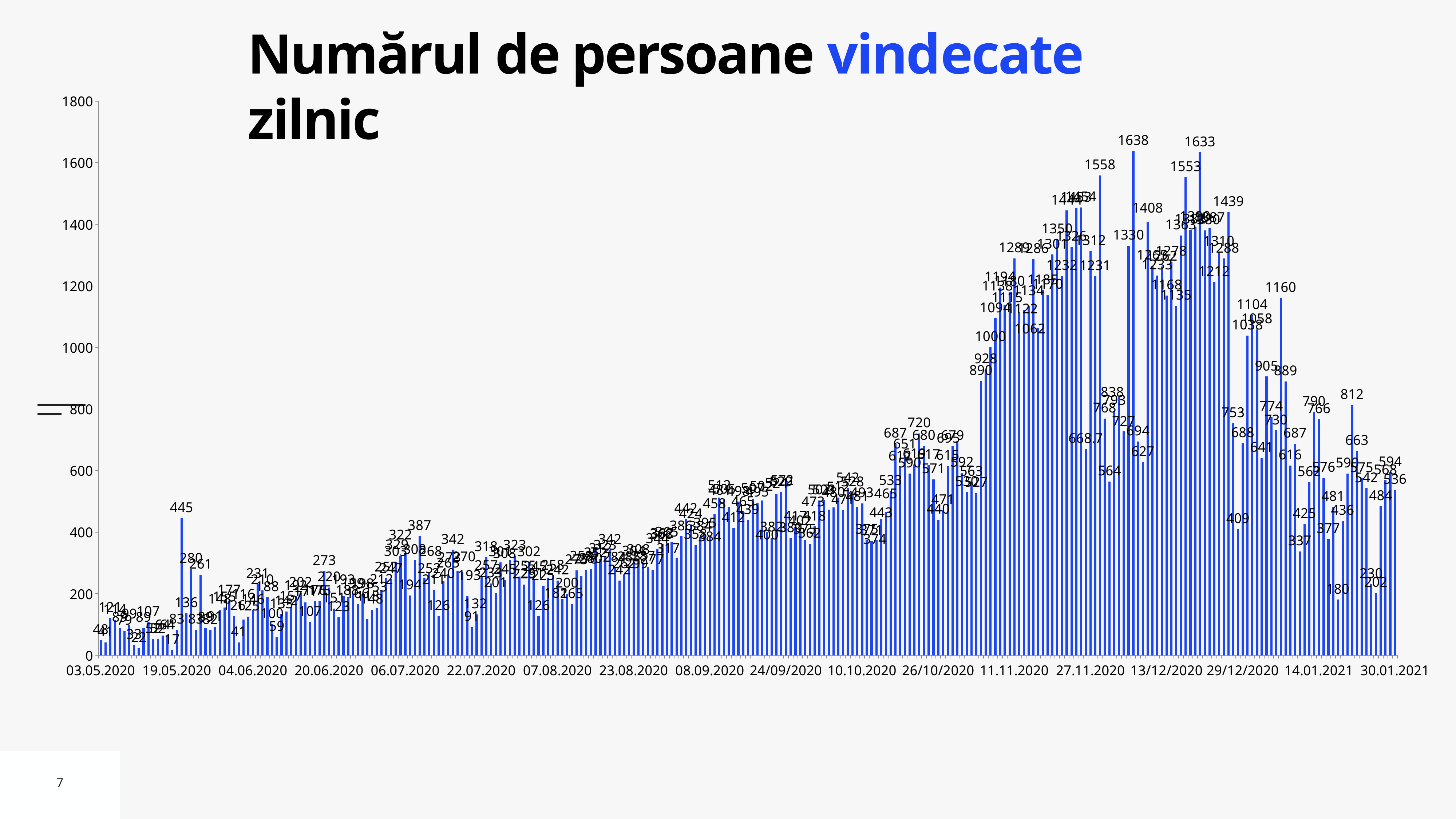
What is the first date shown on the horizontal axis? 03.05.2020 What is the highest daily value labelled on the chart? 1638 What is the value of the last bar on the chart (30.01.2021)? 536 What is the highest value shown on the vertical axis? 1800 Overall, do the daily values rise or fall from May 2020 to November 2020? rise What is the difference between the bar labelled 1160 and the bar labelled 812? 348 What kind of chart is shown on the slide? bar chart What is the difference between the two highest labelled values, 1638 and 1633? 5 How many date labels are shown on the horizontal axis? 18 What is the title of the chart? Numărul de persoane vindecate zilnic Which is larger, the bar labelled 1558 or the bar labelled 1553? 1558 Is the tallest bar in May 2020 (labelled 445) greater or less than 400? greater